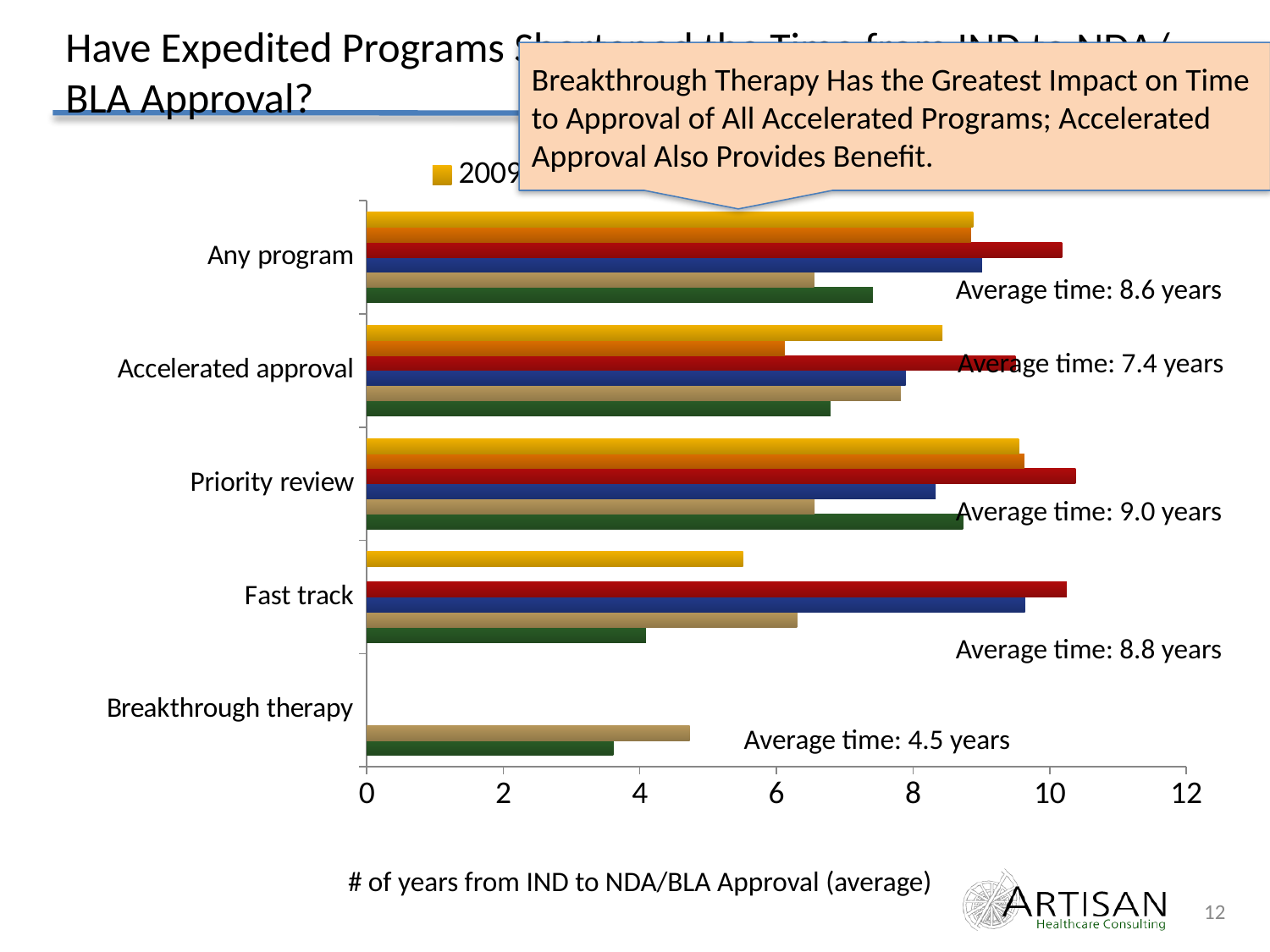
How many program categories are listed on the vertical axis of the chart? 5 What is the maximum value shown on the horizontal axis? 12 What is the average time shown for Fast track? 8.8 years What is the difference between the average time for Any program and the average time for Breakthrough therapy? 4.1 years What kind of chart is shown on the slide? bar chart What is the average time from IND to NDA/BLA approval shown for Breakthrough therapy? 4.5 years What is the average time shown for Priority review? 9.0 years Which program category has the highest average time to approval? Priority review What is the label on the horizontal axis of the chart? # of years from IND to NDA/BLA Approval (average) What is the average time shown for Accelerated approval? 7.4 years Which program category has the lowest average time to approval? Breakthrough therapy Which has a longer average time to approval, Accelerated approval or Fast track? Fast track